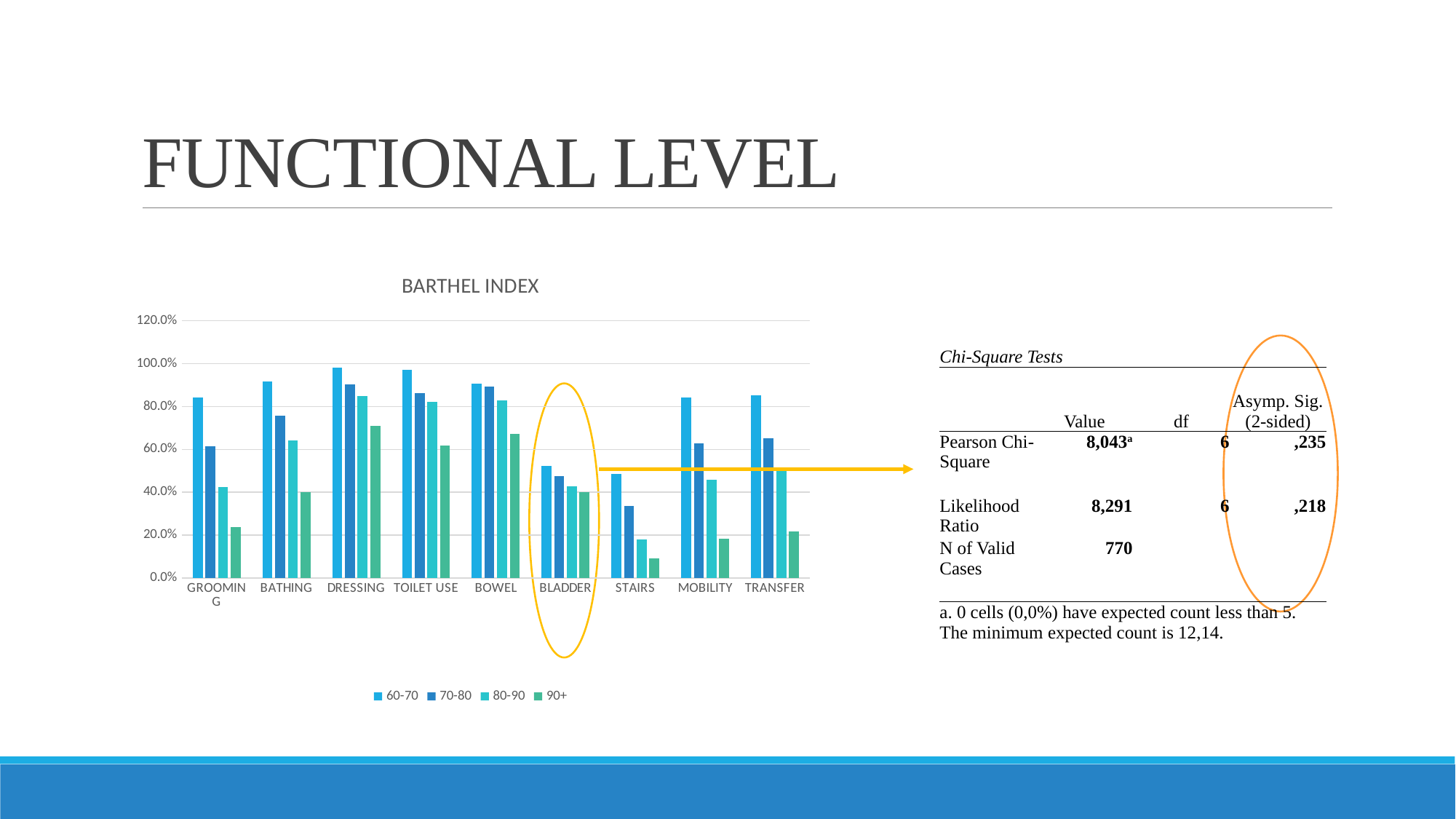
What kind of chart is shown on the slide? bar chart How many categories are shown on the x axis of the chart? 9 For the 60-70 series, which is larger: BATHING or STAIRS? BATHING Is the value for the 90+ series at GROOMING greater or less than 40.0%? less Within each category, do the bars rise or fall going from the 60-70 series to the 90+ series? fall Is the value for the 90+ series at STAIRS greater or less than 20.0%? less Is the value for the 60-70 series at BLADDER greater or less than 40.0%? greater Which category has the lowest value for the 90+ series? STAIRS How many series does the chart's legend list? 4 Which series are listed in the chart's legend? 60-70, 70-80, 80-90, 90+ What is the title of the chart? BARTHEL INDEX